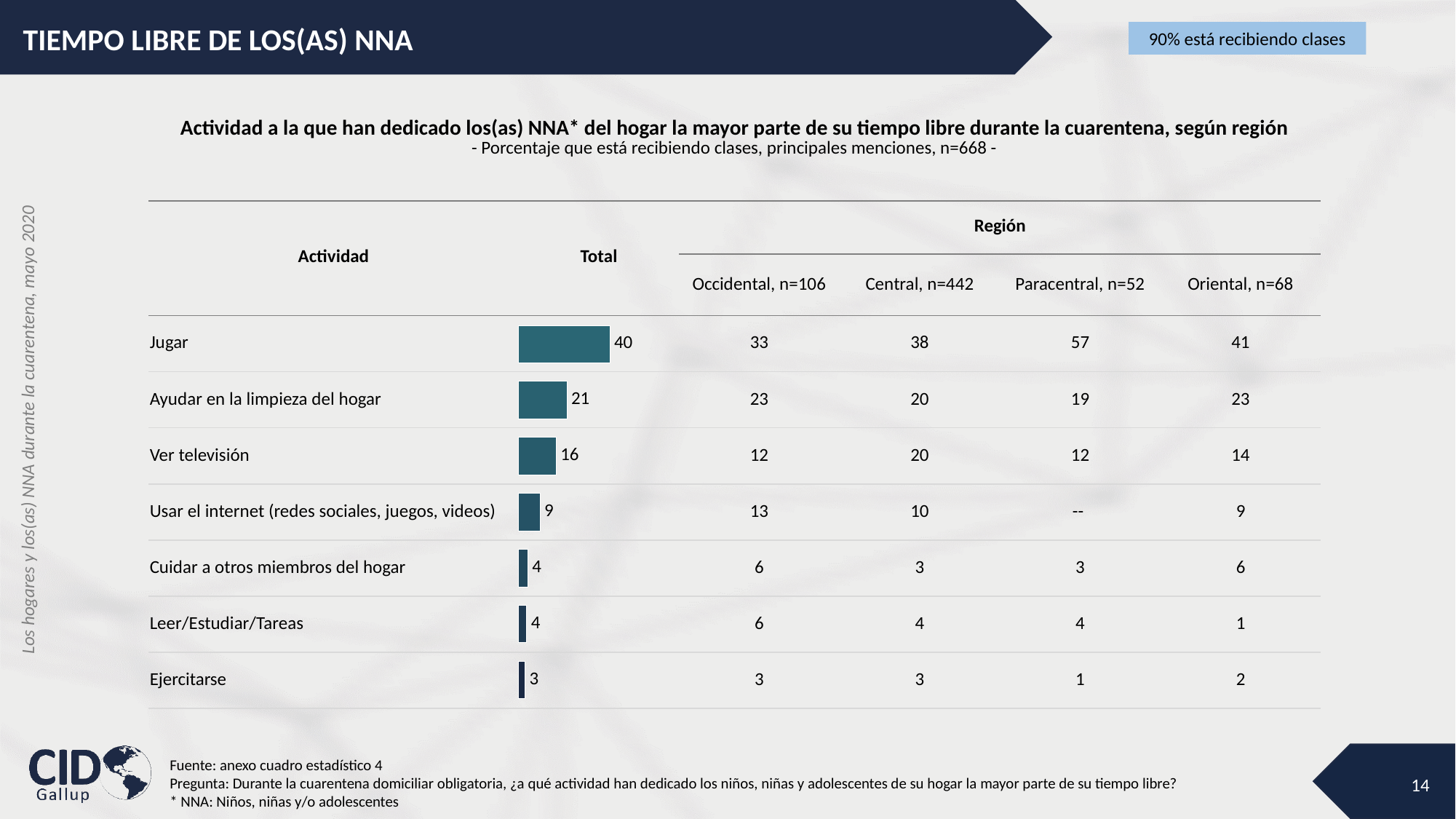
What kind of chart is shown in the Total column of the table? bar chart What is the Total value for Jugar? 40 What is the Total value for Ver televisión? 16 What is the difference between the Total values for Jugar and Ayudar en la limpieza del hogar? 19 What is the Total value for Ayudar en la limpieza del hogar? 21 How many activities are plotted as bars in the Total column? 7 Which activity has the highest Total value? Jugar Which activity has the lowest Total value? Ejercitarse Do the Total bar values rise or fall going down the list of activities from Jugar to Ejercitarse? fall Which has a larger Total value, Ver televisión or Usar el internet (redes sociales, juegos, videos)? Ver televisión What is the sample size (n) stated in the chart subtitle? n=668 What is the Total value for Usar el internet (redes sociales, juegos, videos)? 9